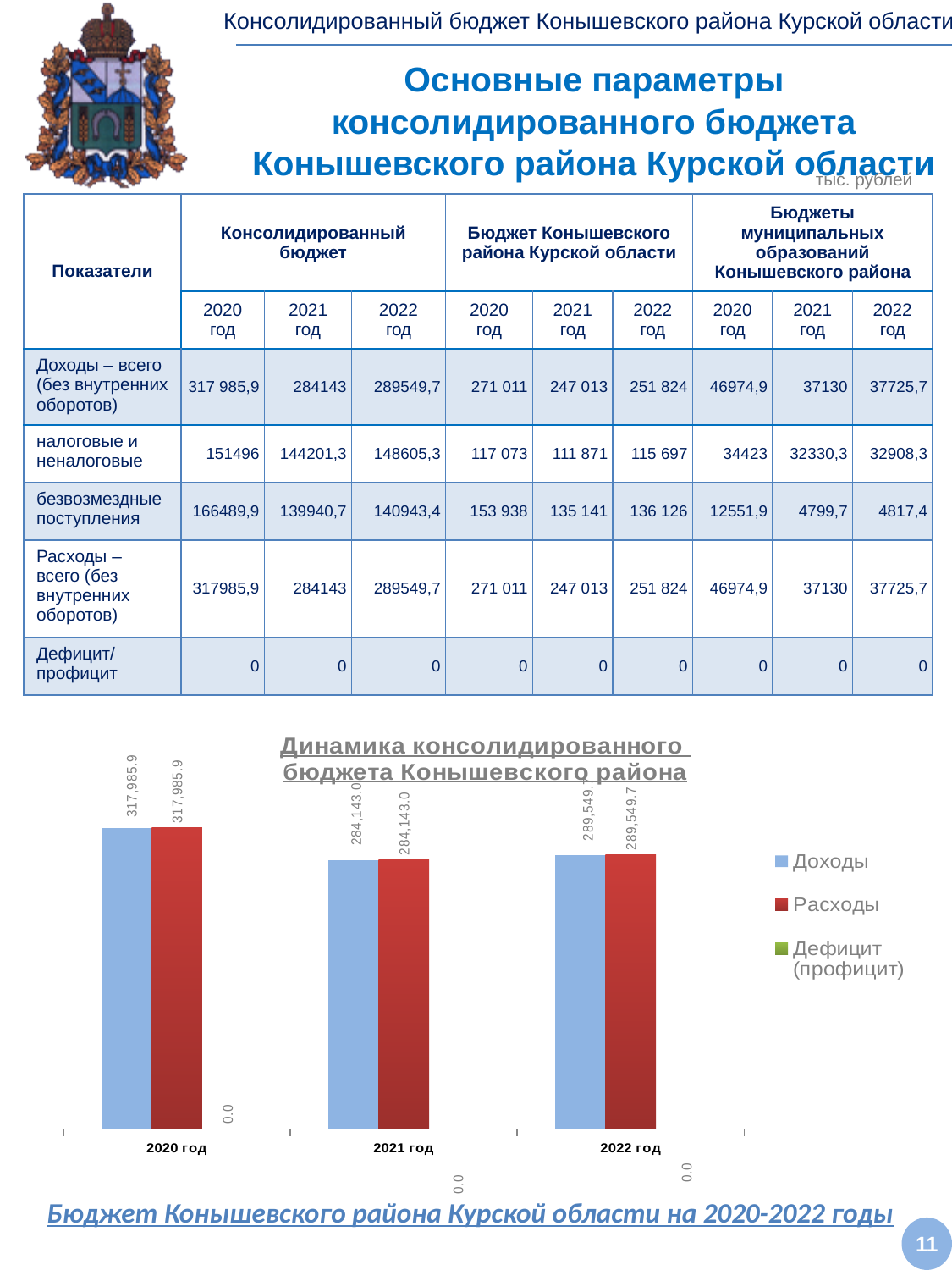
In the chart "Динамика консолидированного бюджета Конышевского района", what is the difference between Доходы in 2020 год and Доходы in 2021 год? 33,842.9 In the chart "Динамика консолидированного бюджета Конышевского района", is Расходы larger in 2022 год or in 2021 год? 2022 год In the chart "Динамика консолидированного бюджета Конышевского района", what is the value of Расходы for 2021 год? 284,143.0 In the chart "Динамика консолидированного бюджета Конышевского района", what is the value of Доходы for 2022 год? 289,549.7 In the chart "Динамика консолидированного бюджета Конышевского района", which year has the highest value of Доходы? 2020 год In the chart "Динамика консолидированного бюджета Конышевского района", which colour represents the Расходы series? red What type of chart is shown under the title "Динамика консолидированного бюджета Конышевского района"? bar chart How many year categories are shown on the x axis of the chart "Динамика консолидированного бюджета Конышевского района"? 3 In the chart "Динамика консолидированного бюджета Конышевского района", which year has the lowest value of Расходы? 2021 год How many series does the legend of the chart "Динамика консолидированного бюджета Конышевского района" list? 3 In the chart "Динамика консолидированного бюджета Конышевского района", what is the value of Дефицит (профицит) for 2020 год? 0.0 In the chart "Динамика консолидированного бюджета Конышевского района", what is the value of Доходы for 2020 год? 317,985.9